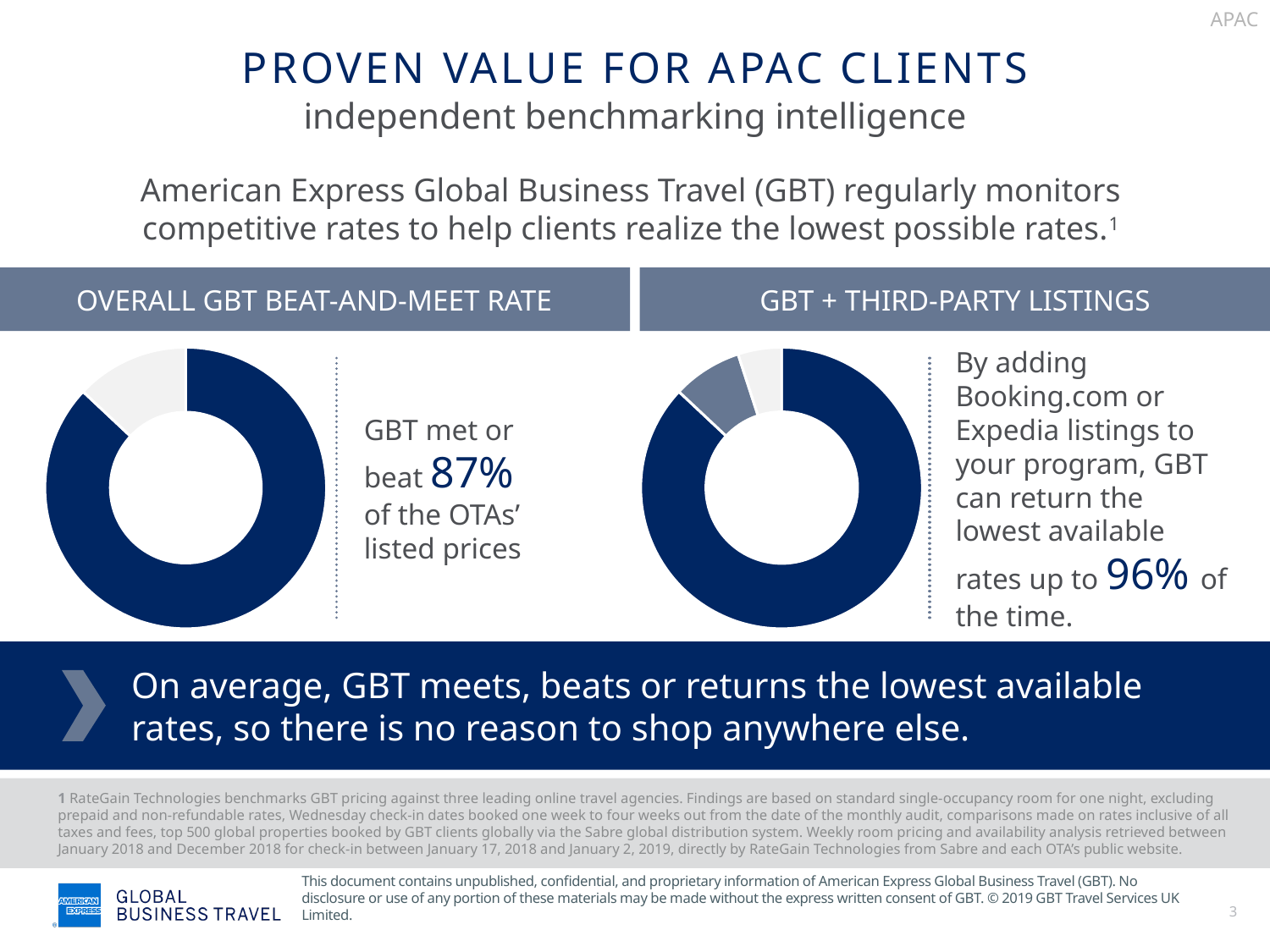
What kind of chart is shown under the heading GBT + THIRD-PARTY LISTINGS? Donut (pie) chart What is the heading above the left-hand donut chart? OVERALL GBT BEAT-AND-MEET RATE Which of the two donut charts shows the higher headline percentage, OVERALL GBT BEAT-AND-MEET RATE or GBT + THIRD-PARTY LISTINGS? GBT + THIRD-PARTY LISTINGS What is the difference between the 96% shown for GBT + THIRD-PARTY LISTINGS and the 87% shown for OVERALL GBT BEAT-AND-MEET RATE? 9% In the GBT + THIRD-PARTY LISTINGS chart, up to what percentage of the time can GBT return the lowest available rates? 96% How many slices does the GBT + THIRD-PARTY LISTINGS donut chart have? 3 How many slices does the OVERALL GBT BEAT-AND-MEET RATE donut chart have? 2 In the OVERALL GBT BEAT-AND-MEET RATE chart, what percentage of the OTAs' listed prices did GBT meet or beat? 87% In the GBT + THIRD-PARTY LISTINGS chart, which colour slice is the largest? Dark blue In the OVERALL GBT BEAT-AND-MEET RATE chart, which slice is larger, the dark blue one or the light grey one? The dark blue one What kind of chart is shown under the heading OVERALL GBT BEAT-AND-MEET RATE? Donut (pie) chart In the GBT + THIRD-PARTY LISTINGS chart, which colour slice is the smallest? Light grey